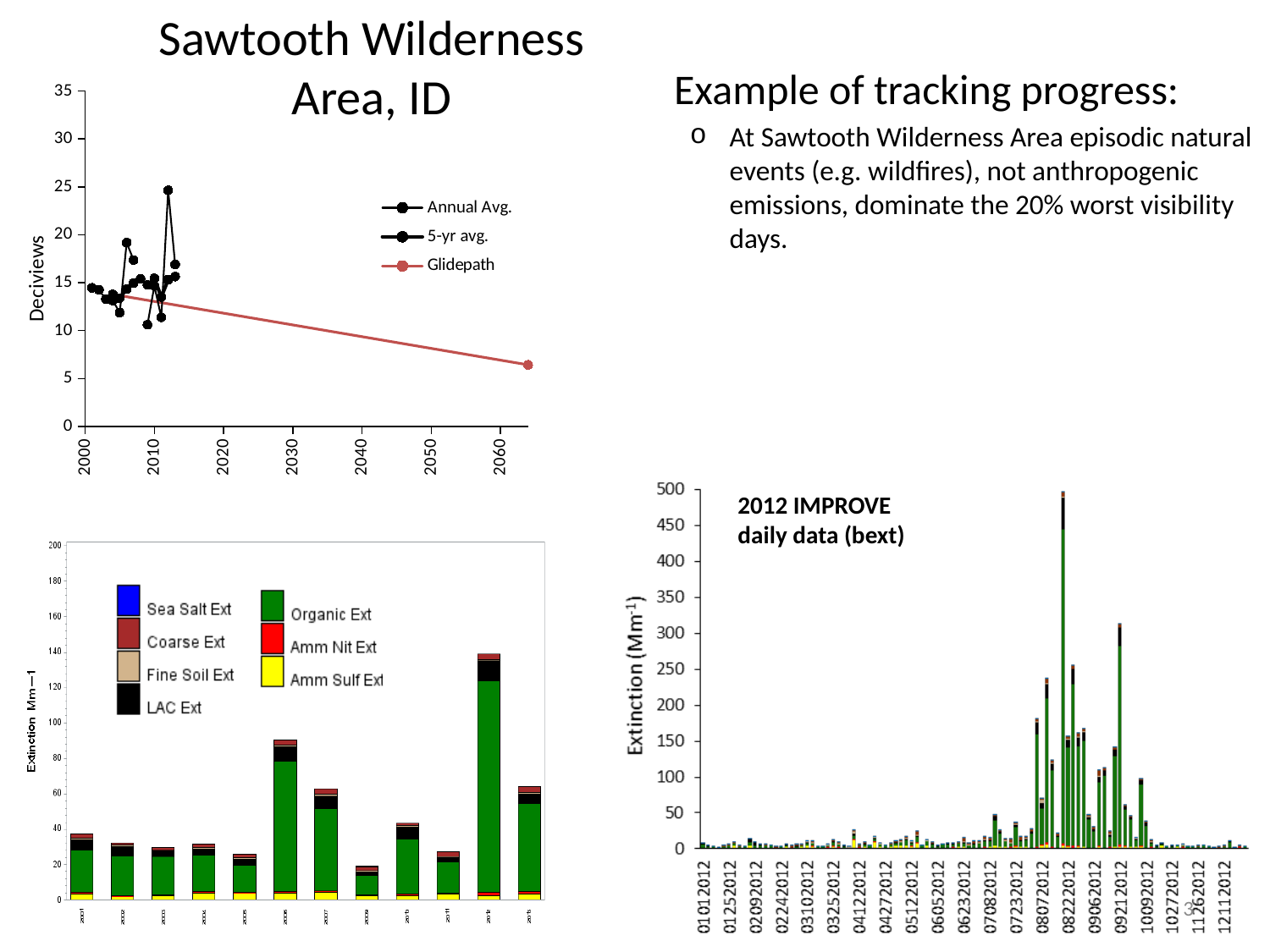
What type of chart is the top-left chart titled 'Sawtooth Wilderness Area, ID'? line chart What is the y-axis label of the top-left chart 'Sawtooth Wilderness Area, ID'? Deciviews In the top-left chart 'Sawtooth Wilderness Area, ID', is the highest Annual Avg. point greater or less than 20 deciviews? greater In the bottom-left stacked bar chart of extinction components, which year has the tallest bar? 2012 In the top-left chart 'Sawtooth Wilderness Area, ID', how many series does the legend list? 3 In the bottom-right chart '2012 IMPROVE daily data (bext)', is the tallest bar greater or less than 450? greater In the bottom-left stacked bar chart of extinction components, is the total for 2012 greater or less than 120? greater What type of chart is the bottom-left chart showing Extinction by year with Sea Salt Ext, Organic Ext and other components? stacked bar chart In the bottom-left stacked bar chart of extinction components, how many entries does the legend list? 7 In the top-left chart 'Sawtooth Wilderness Area, ID', does the Glidepath line rise or fall from left to right? fall In the bottom-left stacked bar chart of extinction components, which colour represents Organic Ext? green